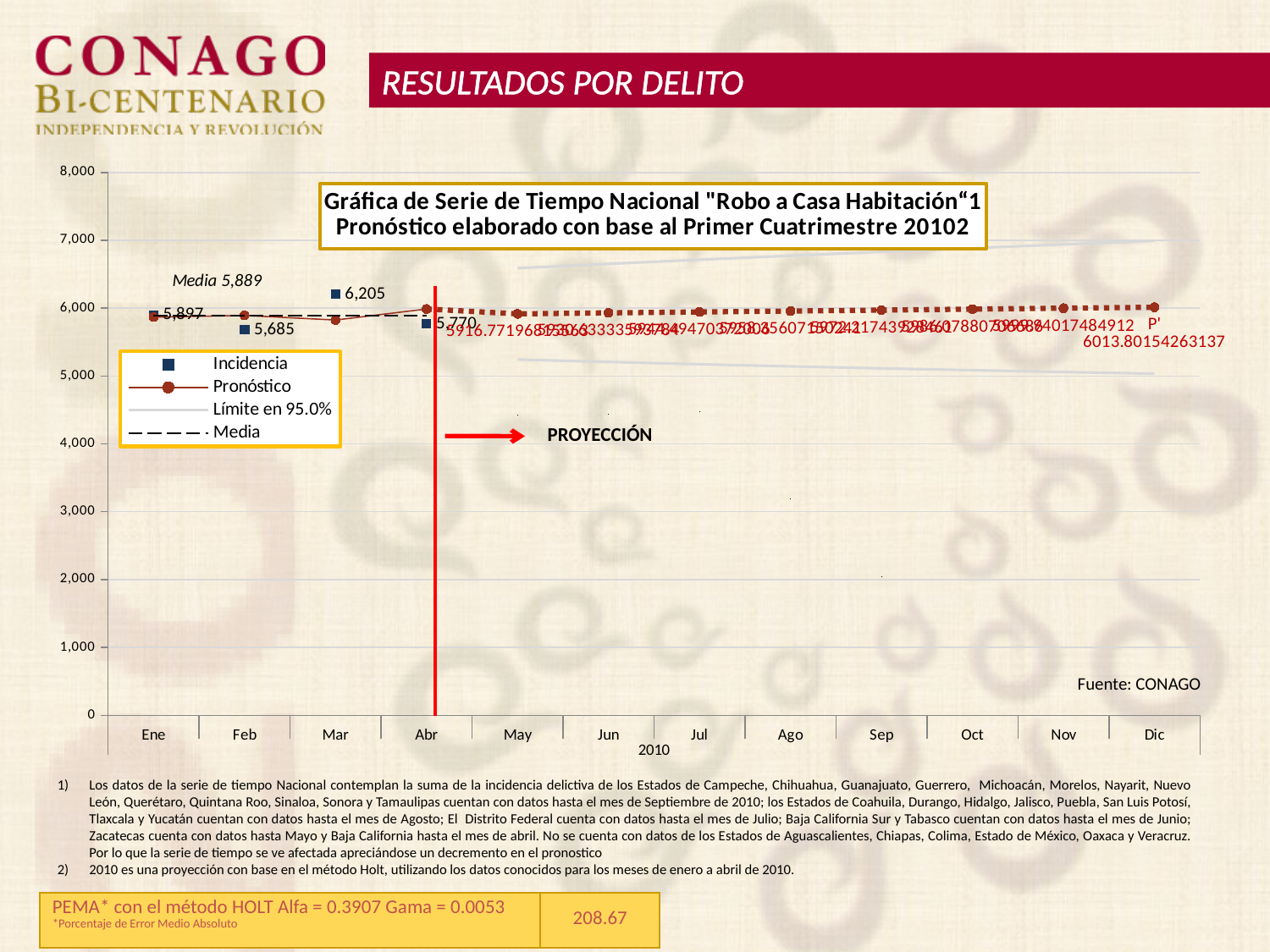
Is the Pronóstico value for Dic greater or less than 5,000? greater What is the Incidencia value for Abr? 5,770 Which month has the lowest Incidencia value? Feb What is the Incidencia value for Ene? 5,897 What is the Incidencia value for Mar? 6,205 What is the value of the Media shown on the chart? 5,889 Which is larger, the Incidencia value for Ene or for Abr? Ene What is the Incidencia value for Feb? 5,685 How many series does the legend list? 4 What kind of chart is shown on the slide? line chart Which month has the highest Incidencia value? Mar What is the difference between the Incidencia values for Mar and Feb? 520